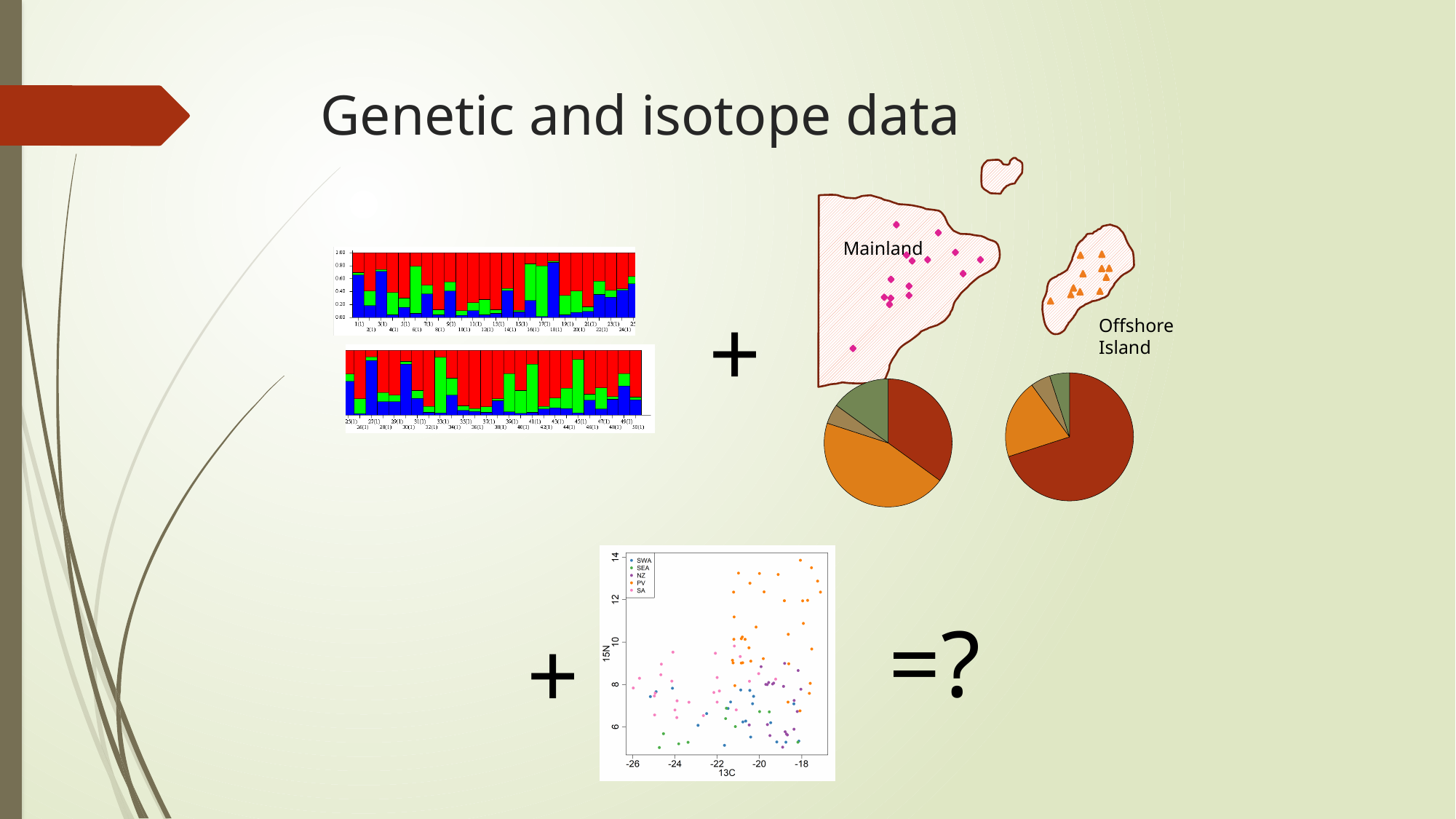
What kind of chart are the two red, green and blue charts on the left of the slide? stacked bar chart What kind of chart is the chart at the bottom of the slide with axes 13C and 15N? scatter plot What is the label of the x axis of the scatter plot at the bottom of the slide? 13C In the scatter plot at the bottom of the slide, which series has the lowest 13C values? SA How many colours (series) are stacked in each bar of the bar charts on the left of the slide? 3 In the scatter plot at the bottom of the slide, which series reaches the highest 15N values? PV How many series does the legend of the scatter plot at the bottom of the slide list? 5 Which slice is the largest in the Offshore Island pie chart? the dark red slice What is the highest tick value on the y axis of the top stacked bar chart on the left of the slide? 1.00 How many pie charts are shown on the slide? 2 How many slices does the Offshore Island pie chart have? 4 What are the series names listed in the legend of the scatter plot at the bottom of the slide? SWA, SEA, NZ, PV, SA